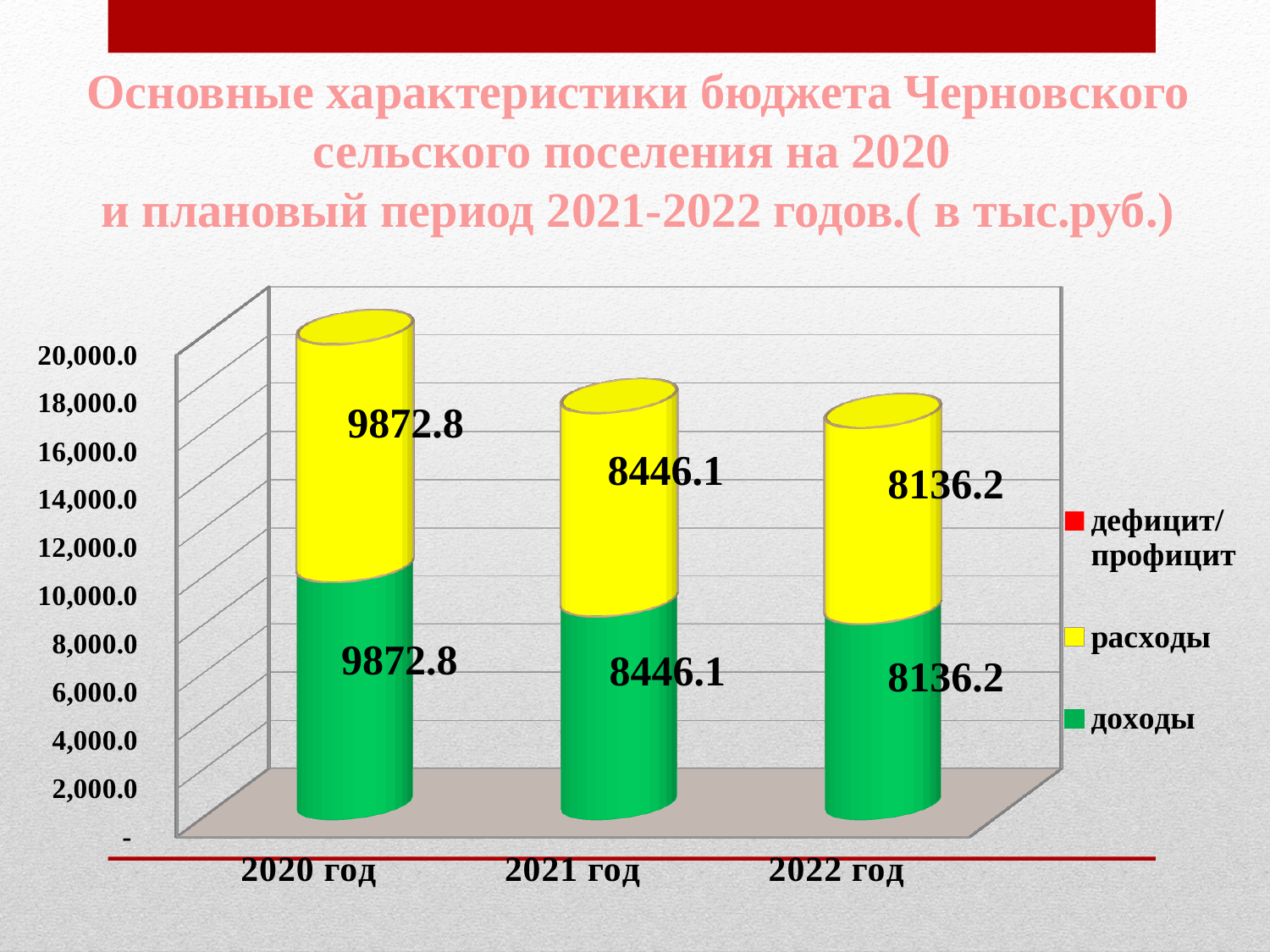
What kind of chart is shown on the slide? stacked bar chart What is the value of доходы for 2022 год? 8136.2 Which year has the lowest value of доходы? 2022 год Which is larger: доходы in 2021 год or доходы in 2022 год? доходы in 2021 год How many years (categories) are shown on the x axis? 3 What is the difference between доходы in 2020 год and доходы in 2021 год? 1426.7 How many series does the legend list? 3 Do the values of доходы rise or fall from 2020 год to 2022 год? fall What is the value of расходы for 2021 год? 8446.1 Which year has the highest value of расходы? 2020 год What is the value of доходы for 2020 год? 9872.8 What is the difference between расходы in 2021 год and расходы in 2022 год? 309.9